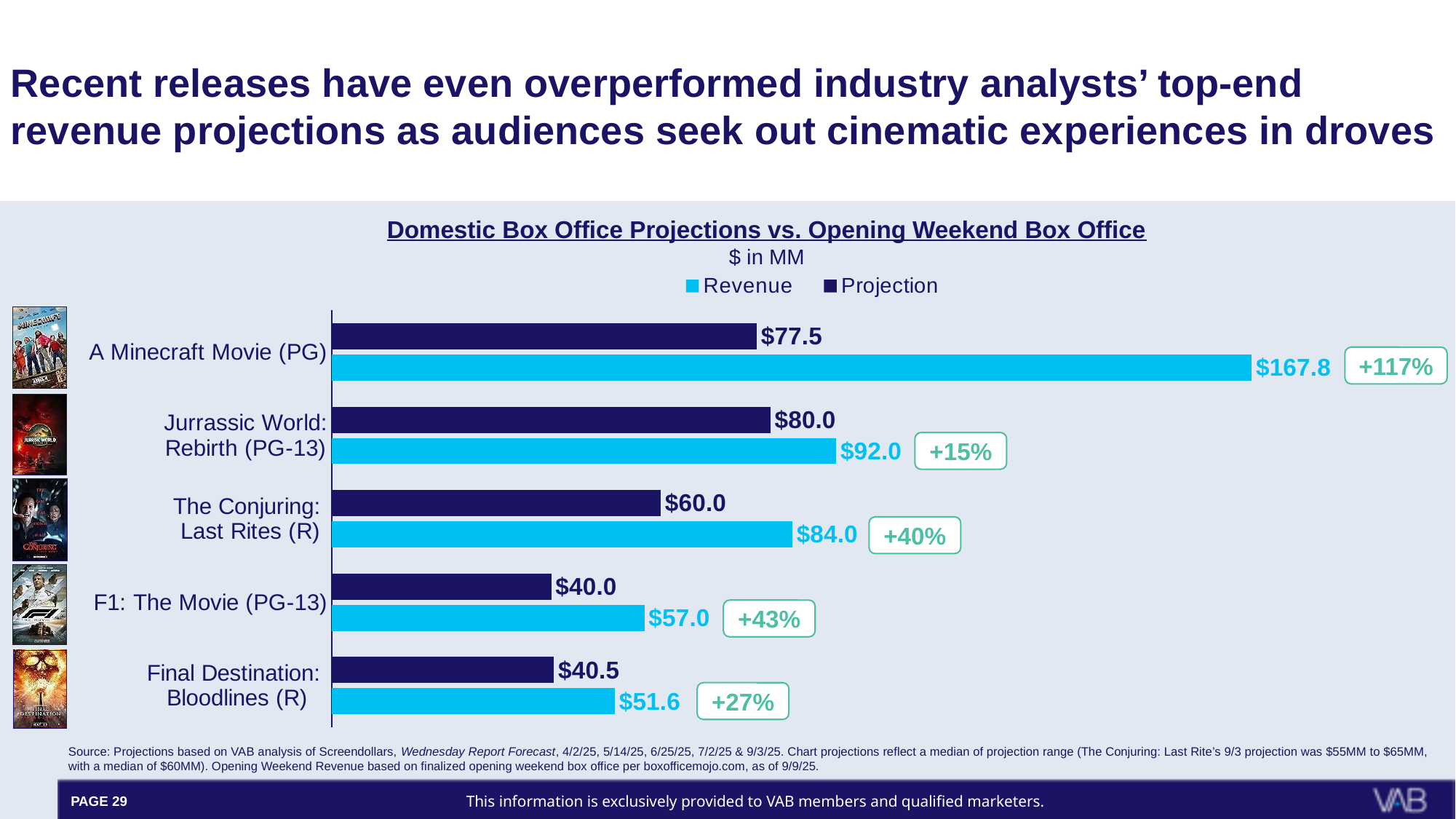
What is the difference between the Revenue and Projection values for A Minecraft Movie (PG)? $90.3 How many series does the legend list? 2 Which is larger for Final Destination: Bloodlines (R), the Revenue or the Projection value? Revenue What is the Revenue value for A Minecraft Movie (PG)? $167.8 What is the Projection value for F1: The Movie (PG-13)? $40.0 Which movie has the highest Revenue value? A Minecraft Movie (PG) What kind of chart is shown on the slide? Bar chart What is the Revenue value for The Conjuring: Last Rites (R)? $84.0 What is the Projection value for Jurrassic World: Rebirth (PG-13)? $80.0 What percentage increase is shown next to the Revenue bar for The Conjuring: Last Rites (R)? +40% How many movies are shown in the chart? 5 Which movie has the lowest Revenue value? Final Destination: Bloodlines (R)